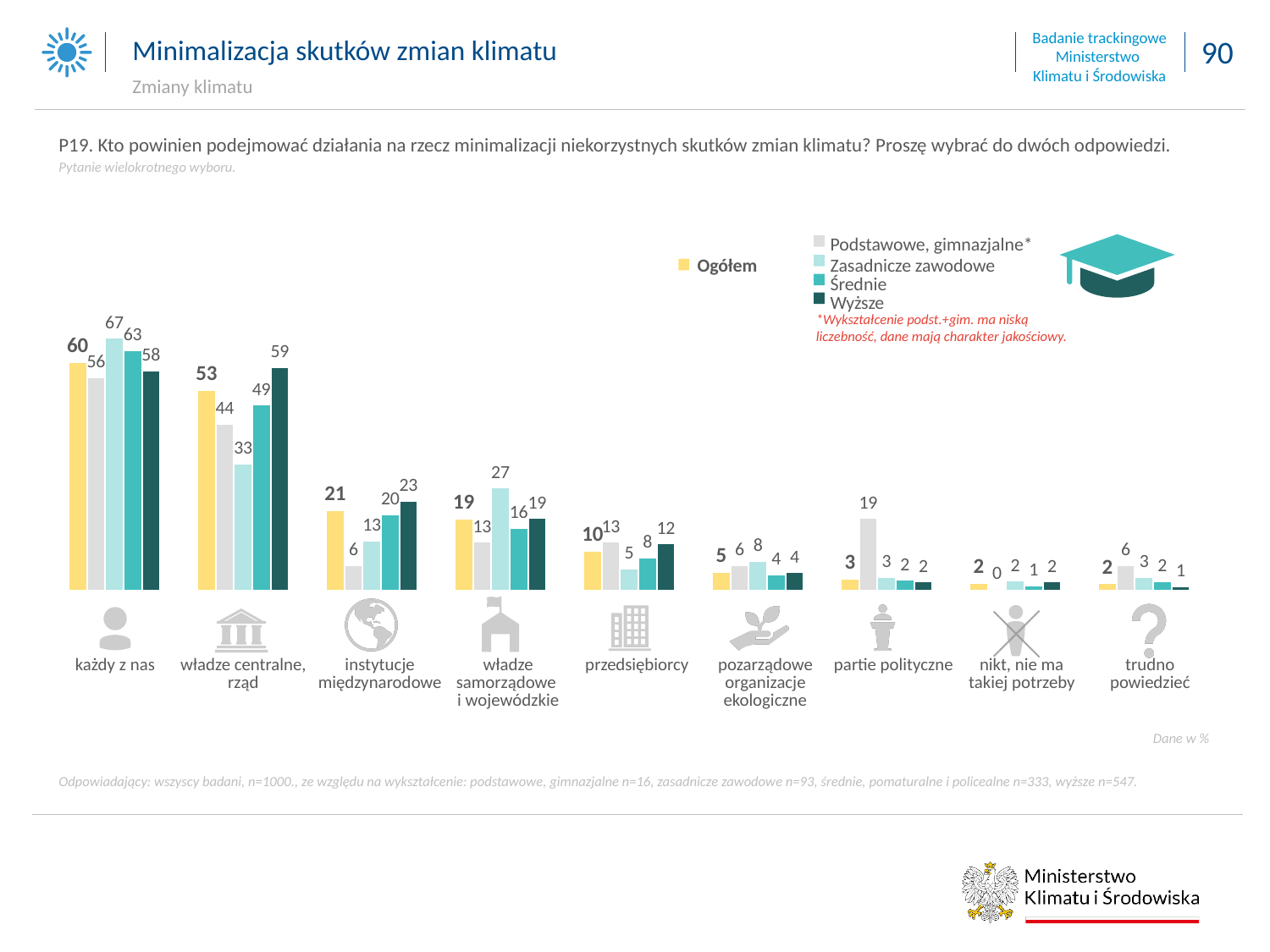
Which category has the highest Ogółem value? każdy z nas Which series is shown in yellow in the legend? Ogółem What kind of chart is shown on the slide? bar chart What is the difference between the Ogółem values for 'każdy z nas' and 'władze centralne, rząd'? 7 For 'instytucje międzynarodowe', which is larger: the Podstawowe, gimnazjalne value or the Średnie value? Średnie What is the Wyższe value for 'władze centralne, rząd'? 59 Which category has the lowest Wyższe value? trudno powiedzieć What is the Ogółem value for 'każdy z nas'? 60 What is the Podstawowe, gimnazjalne value for 'partie polityczne'? 19 How many categories are shown on the x axis? 9 What is the Zasadnicze zawodowe value for 'władze samorządowe i wojewódzkie'? 27 How many series does the legend list? 5